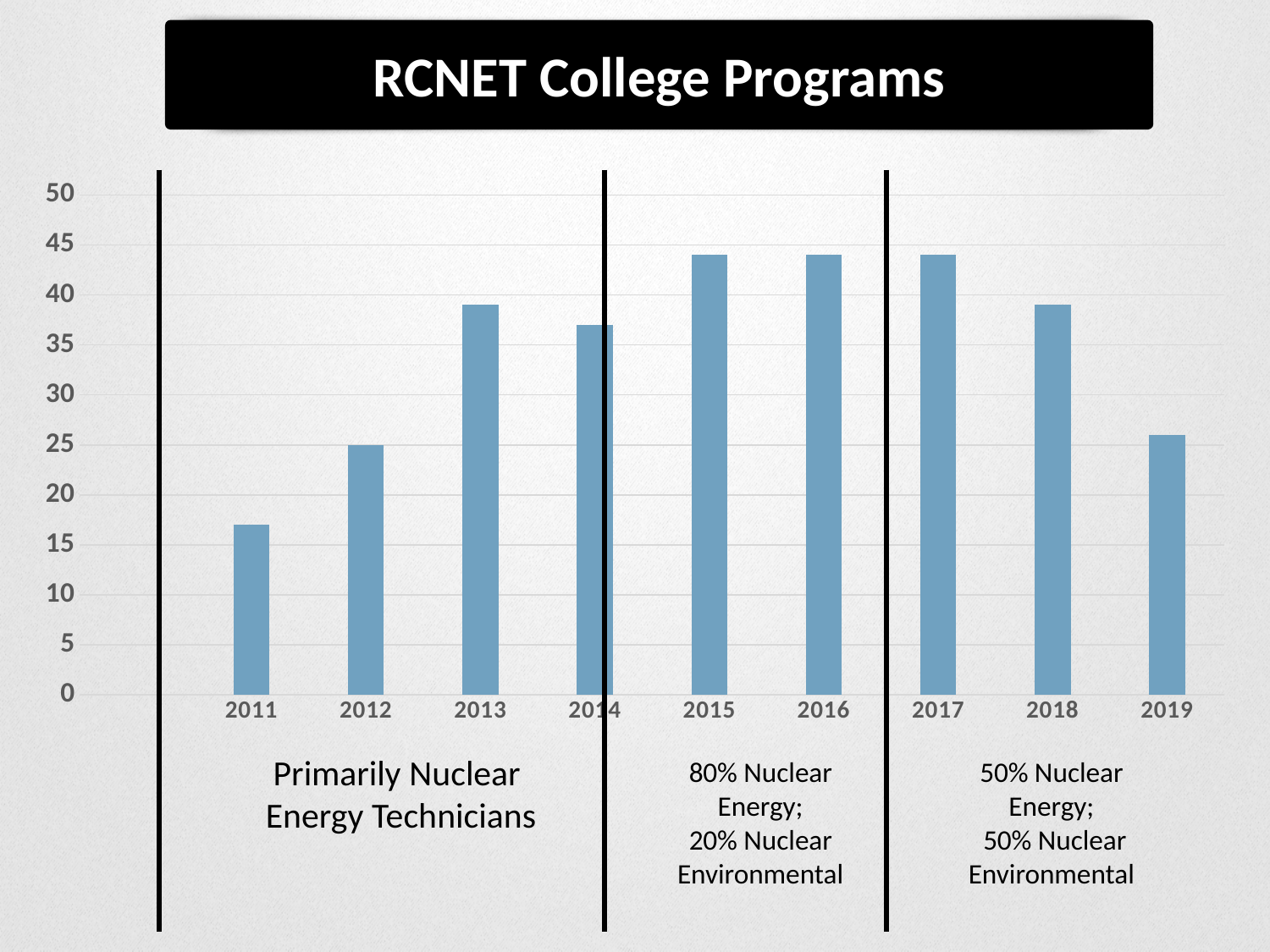
What is the title of the chart? RCNET College Programs Which is larger, the value for 2013 or the value for 2011? 2013 Which is larger, the value for 2019 or the value for 2016? 2016 How many years are shown on the x axis of the chart? 9 Is the value for 2015 greater or less than 40? greater Is the value for 2019 greater or less than 20? greater Is the value for 2011 greater or less than 20? less Do the values rise or fall from 2011 to 2013? rise Do the values rise or fall from 2017 to 2019? fall What kind of chart is shown on the slide? bar chart Which year has the lowest value in the chart? 2011